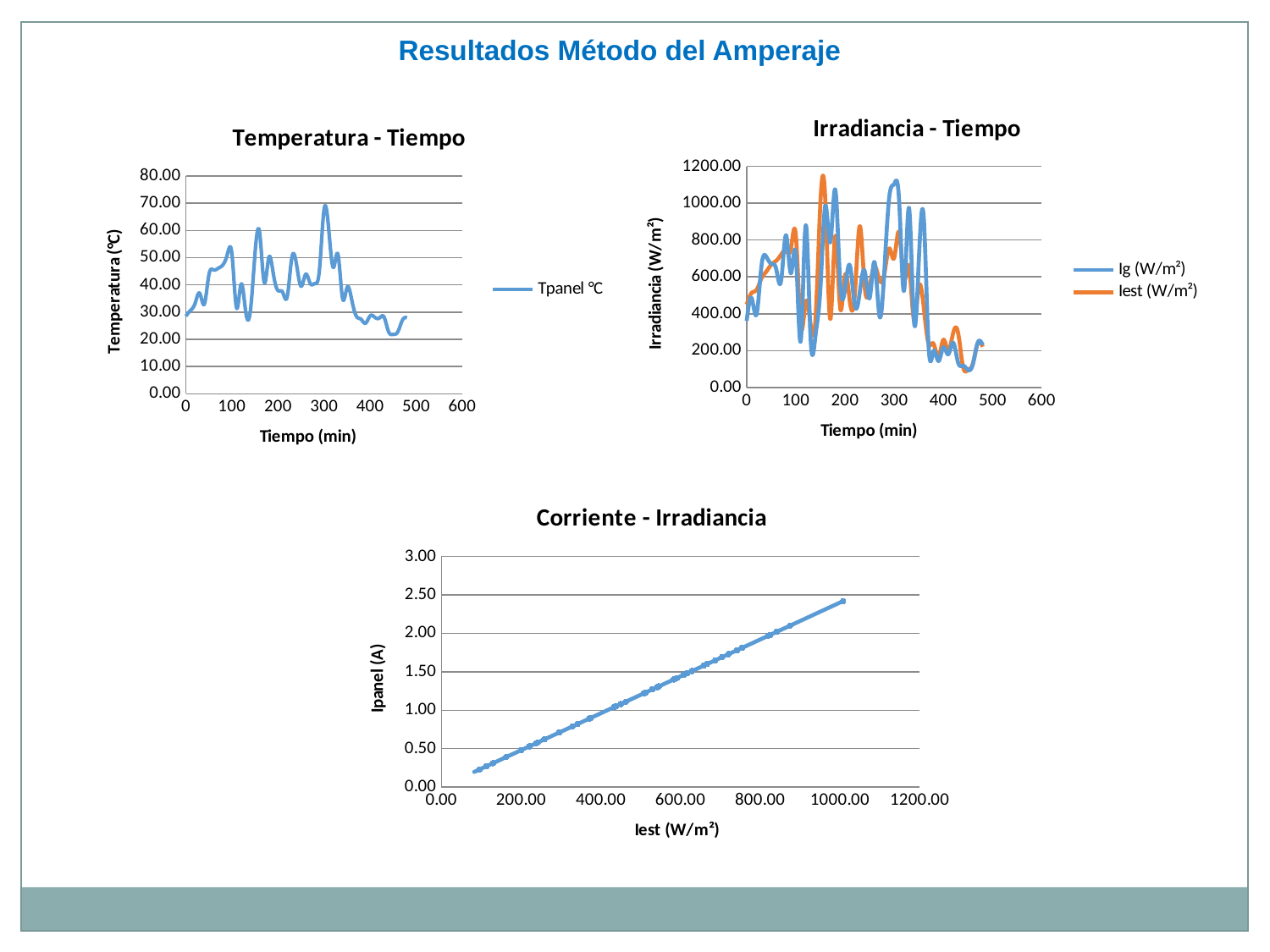
In the "Irradiancia - Tiempo" chart, is the value of Iest at time 0 greater or less than 600.00? less What kind of chart is the "Temperatura - Tiempo" chart? line chart What are the legend entries of the "Irradiancia - Tiempo" chart? Ig (W/m²) and Iest (W/m²) What is the x-axis label of the "Corriente - Irradiancia" chart? Iest (W/m²) In the "Temperatura - Tiempo" chart, is the highest value of Tpanel greater or less than 60.00? greater How many series does the legend of the "Temperatura - Tiempo" chart list? 1 In the "Temperatura - Tiempo" chart, is the value of Tpanel at time 0 greater or less than 40.00? less How many series does the legend of the "Irradiancia - Tiempo" chart list? 2 In the "Corriente - Irradiancia" chart, does Ipanel rise or fall as Iest increases? rises